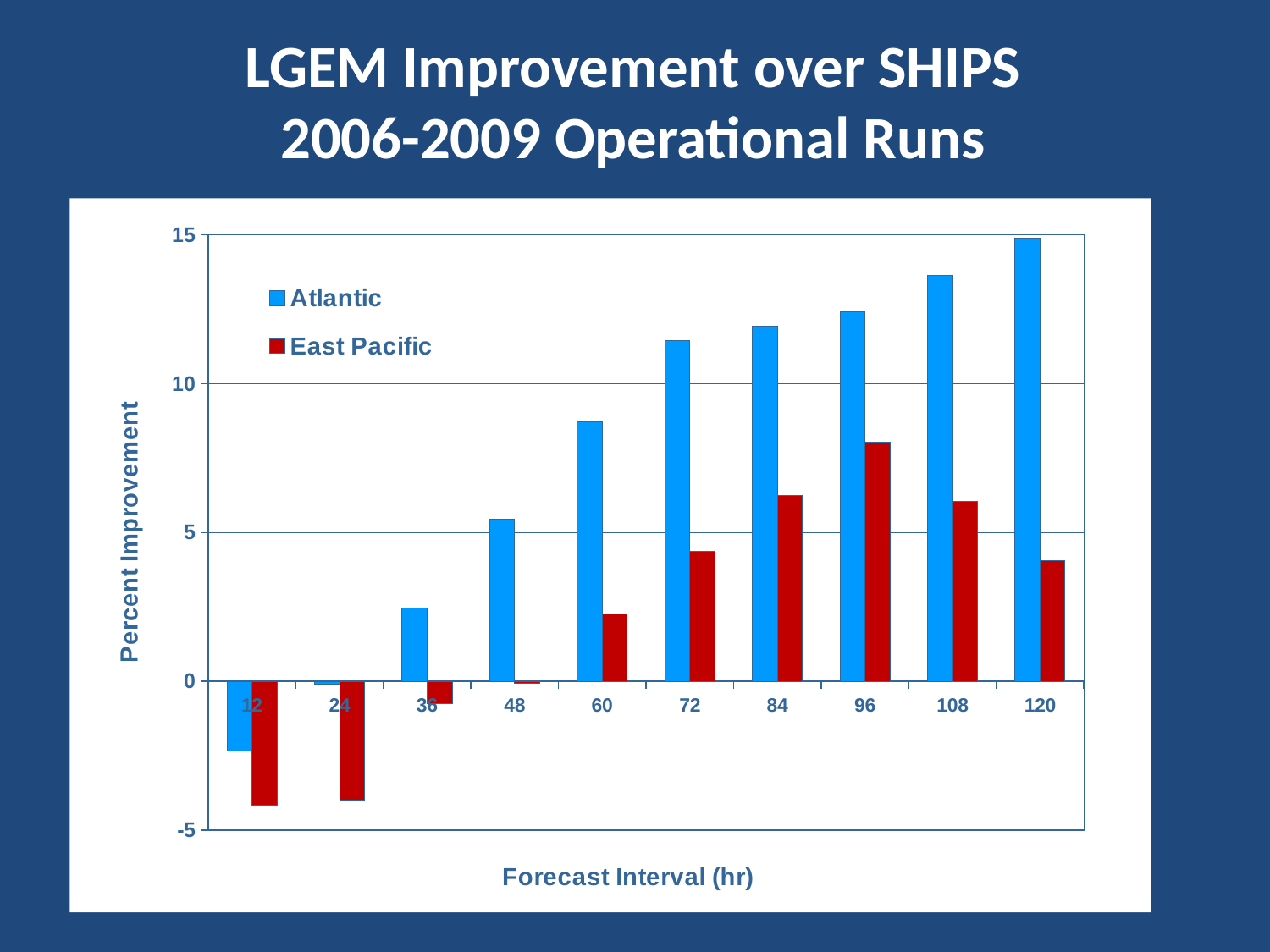
At which forecast interval is the Atlantic percent improvement highest? 120 Do the Atlantic values generally rise or fall as the forecast interval increases? rise How many series does the legend list? 2 At which forecast interval is the Atlantic percent improvement lowest? 12 Is the Atlantic value at 48 hr greater or less than 5? greater What kind of chart is shown on the slide? bar chart At which forecast interval is the East Pacific percent improvement highest? 96 How many forecast intervals are shown on the x axis? 10 What is the label of the y axis? Percent Improvement At 84 hr, which series has the larger percent improvement, Atlantic or East Pacific? Atlantic Is the Atlantic value at 72 hr greater or less than 10? greater Is the East Pacific value at 120 hr greater or less than 5? less